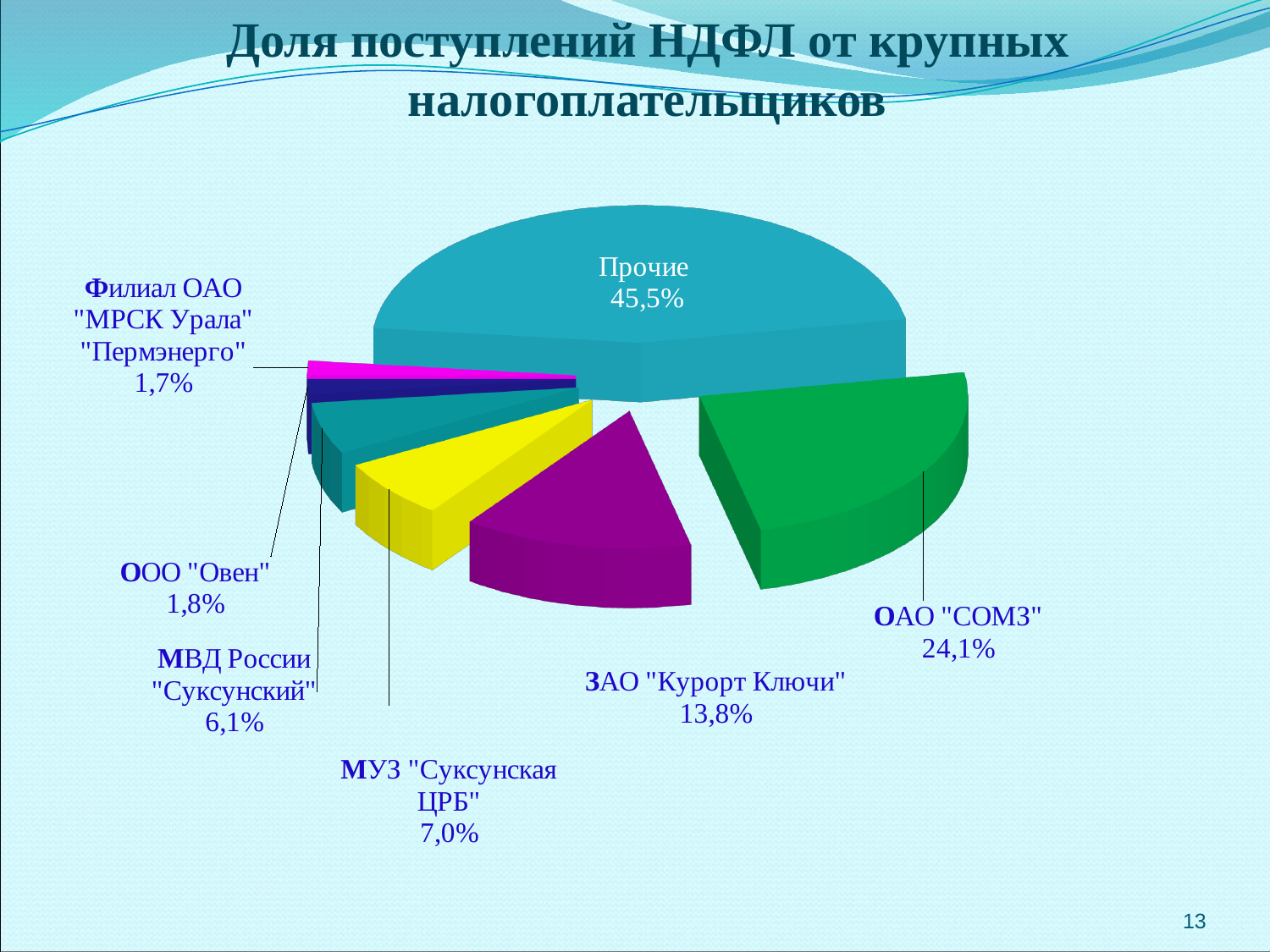
Which category has the smallest share in the pie chart? Филиал ОАО "МРСК Урала" "Пермэнерго" What is the share of ОАО "СОМЗ" in the pie chart? 24,1% How many slices does the pie chart have? 7 What share is shown for МВД России "Суксунский"? 6,1% What type of chart is shown on the slide? pie chart What is the difference between the shares of ОАО "СОМЗ" and ЗАО "Курорт Ключи"? 10,3% What share does ЗАО "Курорт Ключи" have in the pie chart? 13,8% What is the value for Филиал ОАО "МРСК Урала" "Пермэнерго"? 1,7% What is the title of the chart on the slide? Доля поступлений НДФЛ от крупных налогоплательщиков Which category has the largest slice of the pie? Прочие What is the value shown for МУЗ "Суксунская ЦРБ"? 7,0% Which is larger: the share of ООО "Овен" or the share of МВД России "Суксунский"? МВД России "Суксунский"